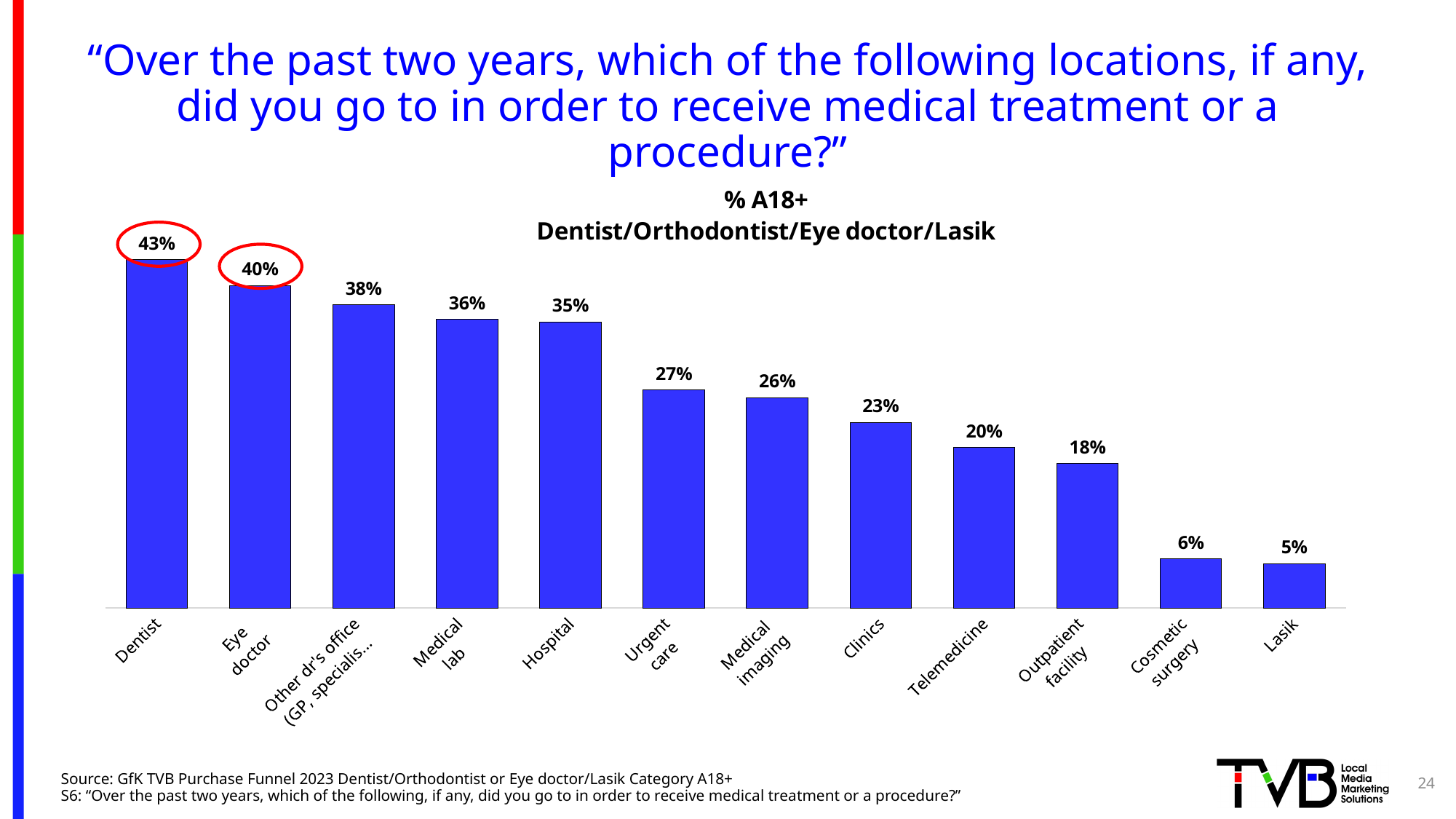
What is the difference between the Hospital and Clinics percentages? 12% Do the values rise or fall moving from left to right across the chart? Fall What kind of chart is shown on the slide? Bar chart What percentage of A18+ went to a dentist for medical treatment or a procedure? 43% How many locations are shown in the chart? 12 What is the value shown for Urgent care? 27% Which location has the highest percentage? Dentist Which location has the lowest percentage? Lasik Which is larger, the value for Medical lab or the value for Medical imaging? Medical lab Which two bars have their data labels circled in red? Dentist and Eye doctor What is the difference between the Dentist and Eye doctor percentages? 3% What is the value shown for Telemedicine? 20%